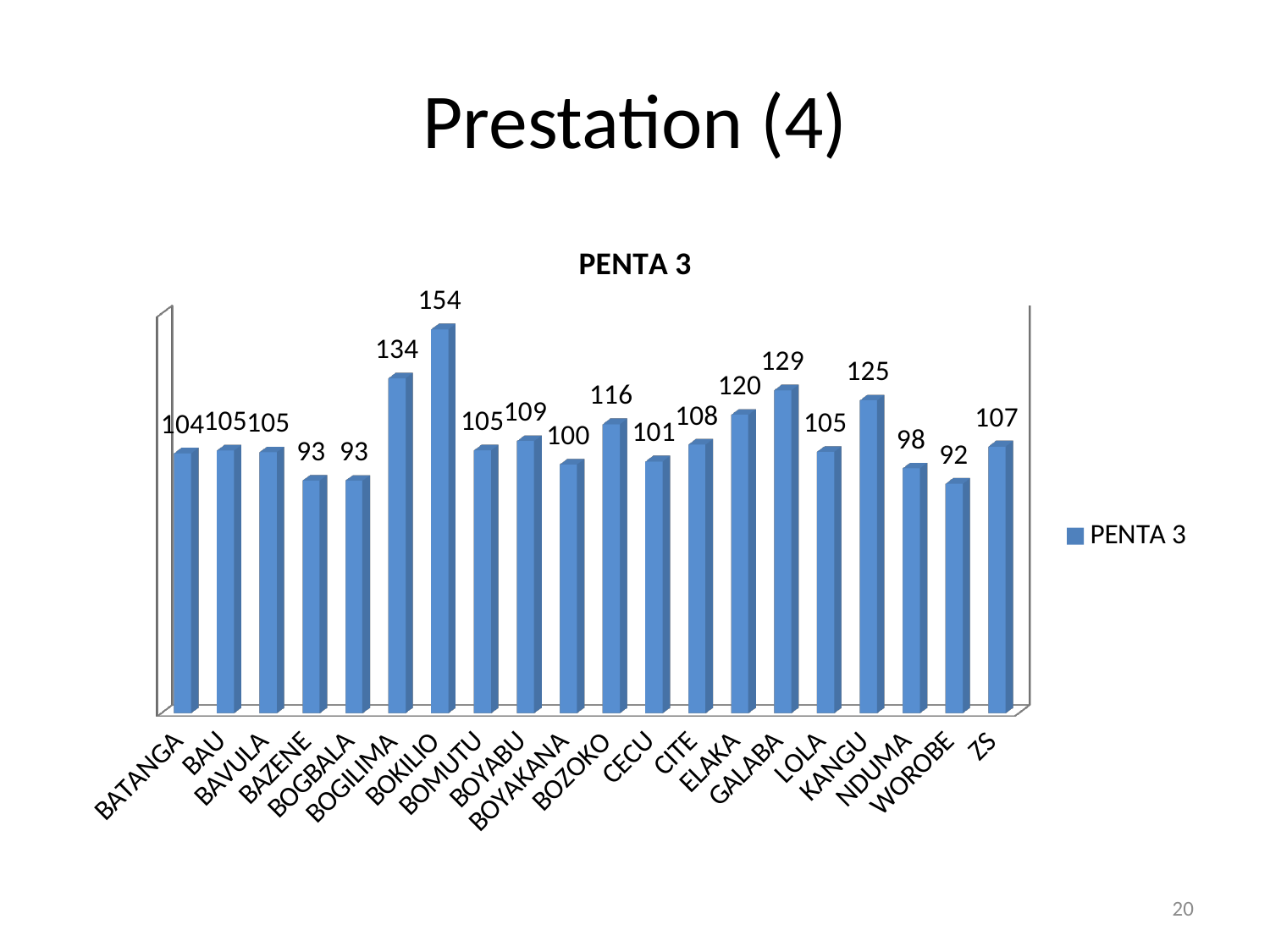
Which is larger, the value for ELAKA or the value for BOZOKO? ELAKA How many categories are shown on the x axis? 20 What is the difference between the values for KANGU and NDUMA? 27 What kind of chart is shown on the slide? Bar chart What is the difference between the values for BOKILIO and BOGILIMA? 20 What is the value for ZS? 107 How many series does the legend list? 1 What is the value for GALABA? 129 What is the value for BOKILIO? 154 Which category has the lowest value? WOROBE What is the value for WOROBE? 92 Which category has the highest value? BOKILIO